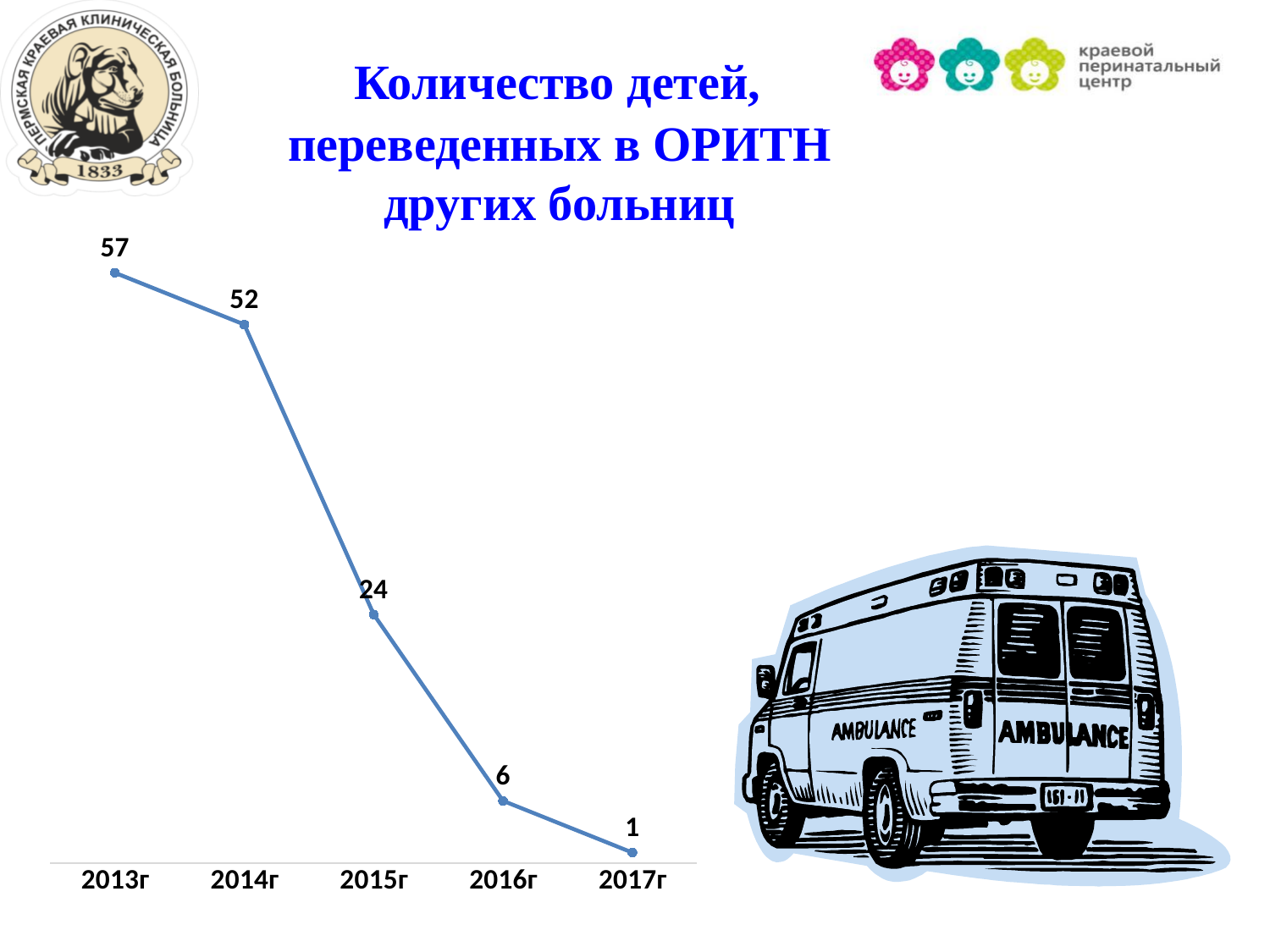
What is the difference between the values for 2014г and 2015г? 28 Which is larger, the value for 2015г or the value for 2016г? 2015г What is the value for 2013г? 57 How many years are plotted on the chart? 5 What kind of chart is shown on the slide? line chart Which year has the highest value? 2013г What is the title of the chart? Количество детей, переведенных в ОРИТН других больниц What is the difference between the values for 2013г and 2014г? 5 What is the value for 2017г? 1 What is the value for 2015г? 24 Do the values rise or fall from 2013г to 2017г? fall Which year has the lowest value? 2017г